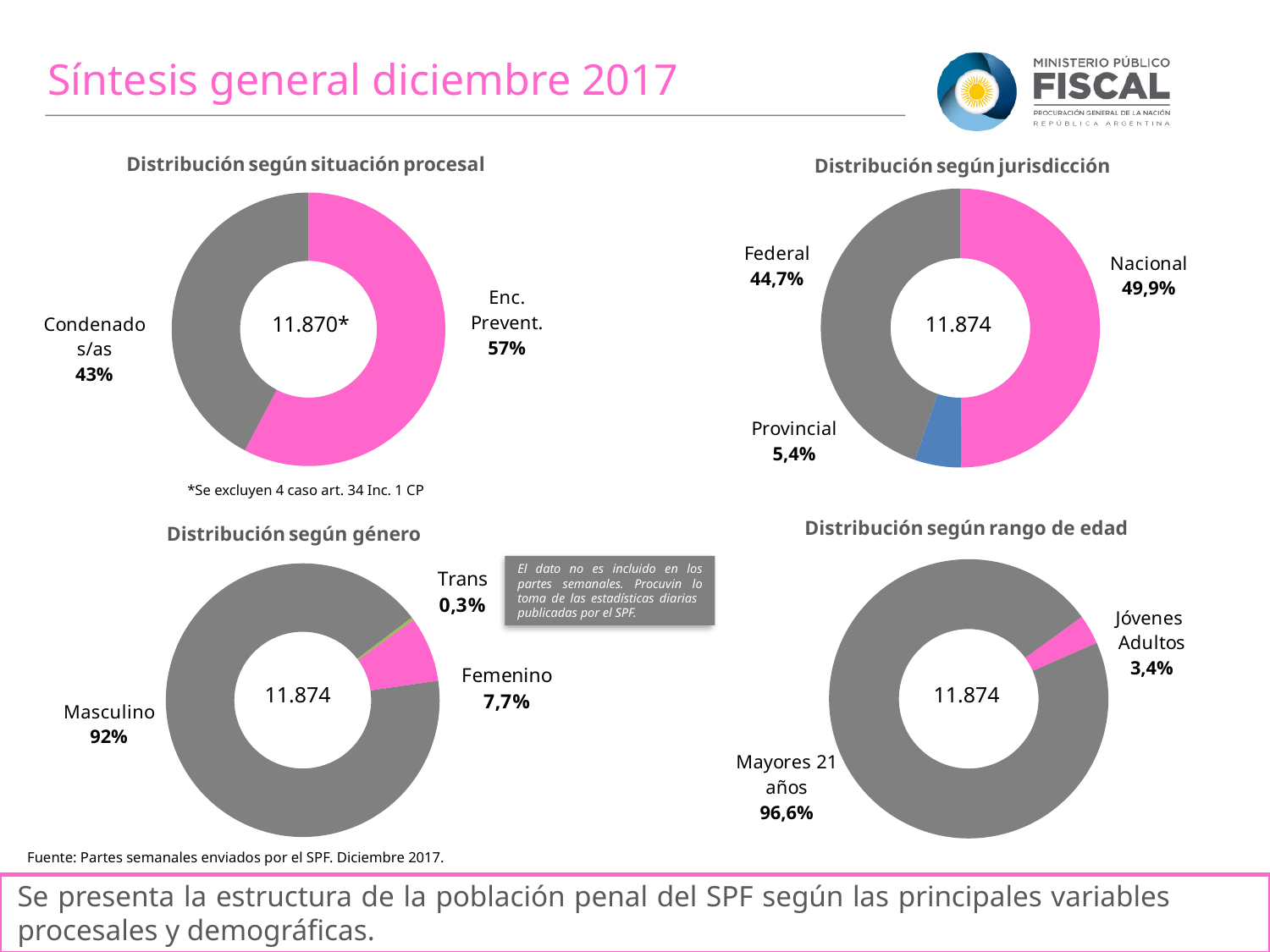
In the 'Distribución según género' chart, what share is labelled for Femenino? 7,7% In the 'Distribución según jurisdicción' chart, which category has the largest share? Nacional In the 'Distribución según jurisdicción' chart, what share is labelled for Federal? 44,7% In the 'Distribución según jurisdicción' chart, how many categories are shown? 3 What kind of chart is 'Distribución según rango de edad'? Donut (pie) chart In the 'Distribución según rango de edad' chart, what is the difference between the shares for Mayores 21 años and Jóvenes Adultos? 93,2% In the 'Distribución según género' chart, what share is labelled for Trans? 0,3% In the 'Distribución según situación procesal' chart, what share is labelled for Enc. Prevent.? 57% In the 'Distribución según situación procesal' chart, what share is labelled for Condenados/as? 43% In the 'Distribución según rango de edad' chart, what share is labelled for Jóvenes Adultos? 3,4% In the 'Distribución según género' chart, which is larger, Masculino or Femenino? Masculino In the 'Distribución según jurisdicción' chart, which category has the smallest share? Provincial